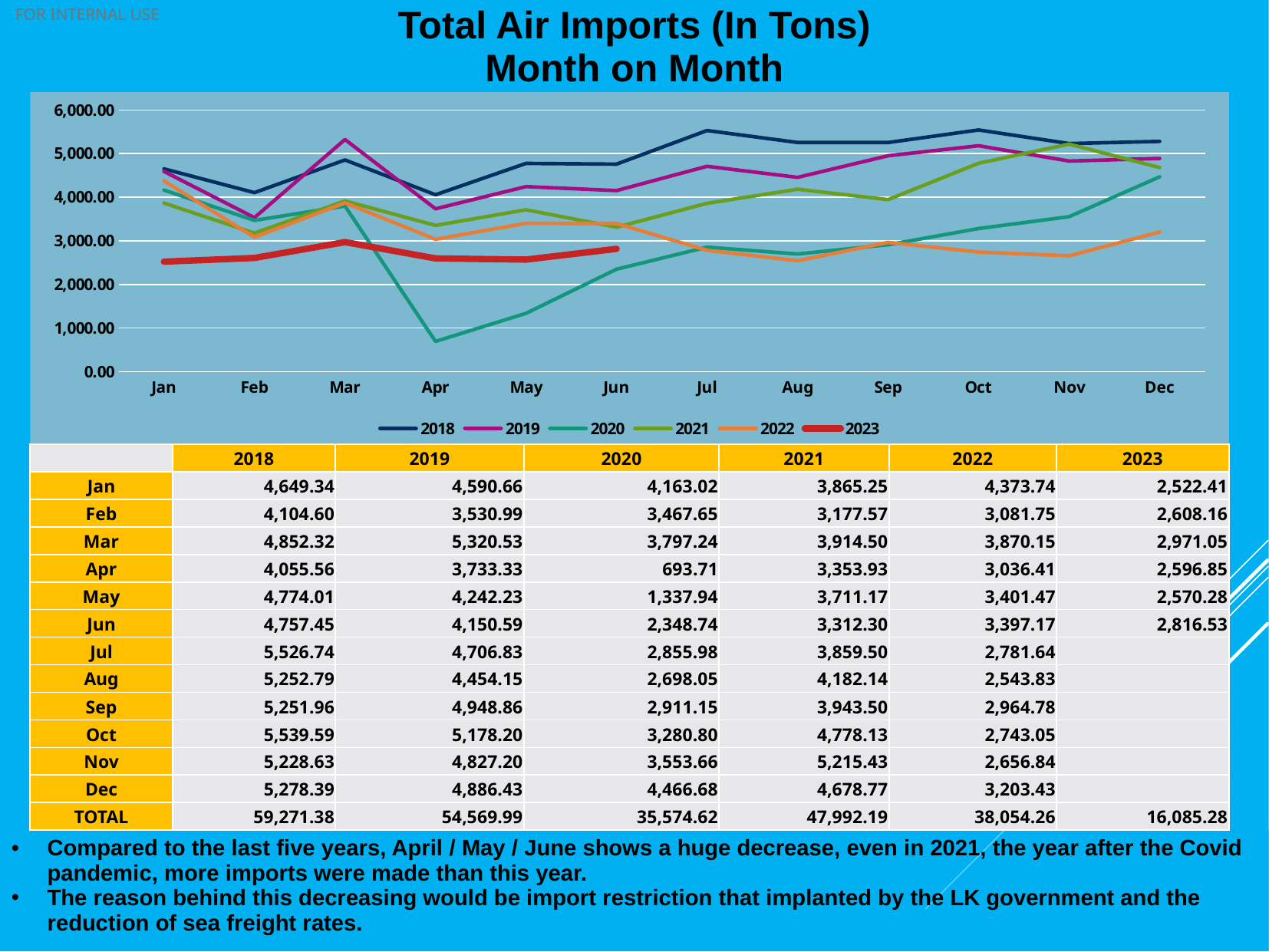
What is the value for April in the 2020 series? 693.71 Which month has the highest value in the 2019 series? Mar What is the value for July in the 2018 series? 5,526.74 How many series does the chart legend list? 6 What is the difference between the January values for 2018 and 2023? 2,126.93 How many months are plotted along the x axis? 12 What kind of chart is shown on the slide? Line chart Which is larger for October: the 2021 value or the 2022 value? 2021 Is the value for April in the 2020 series greater or less than 1,000.00? less What is the value for June in the 2023 series? 2,816.53 Which month has the lowest value in the 2020 series? Apr Does the 2020 series rise or fall from April to December? Rise